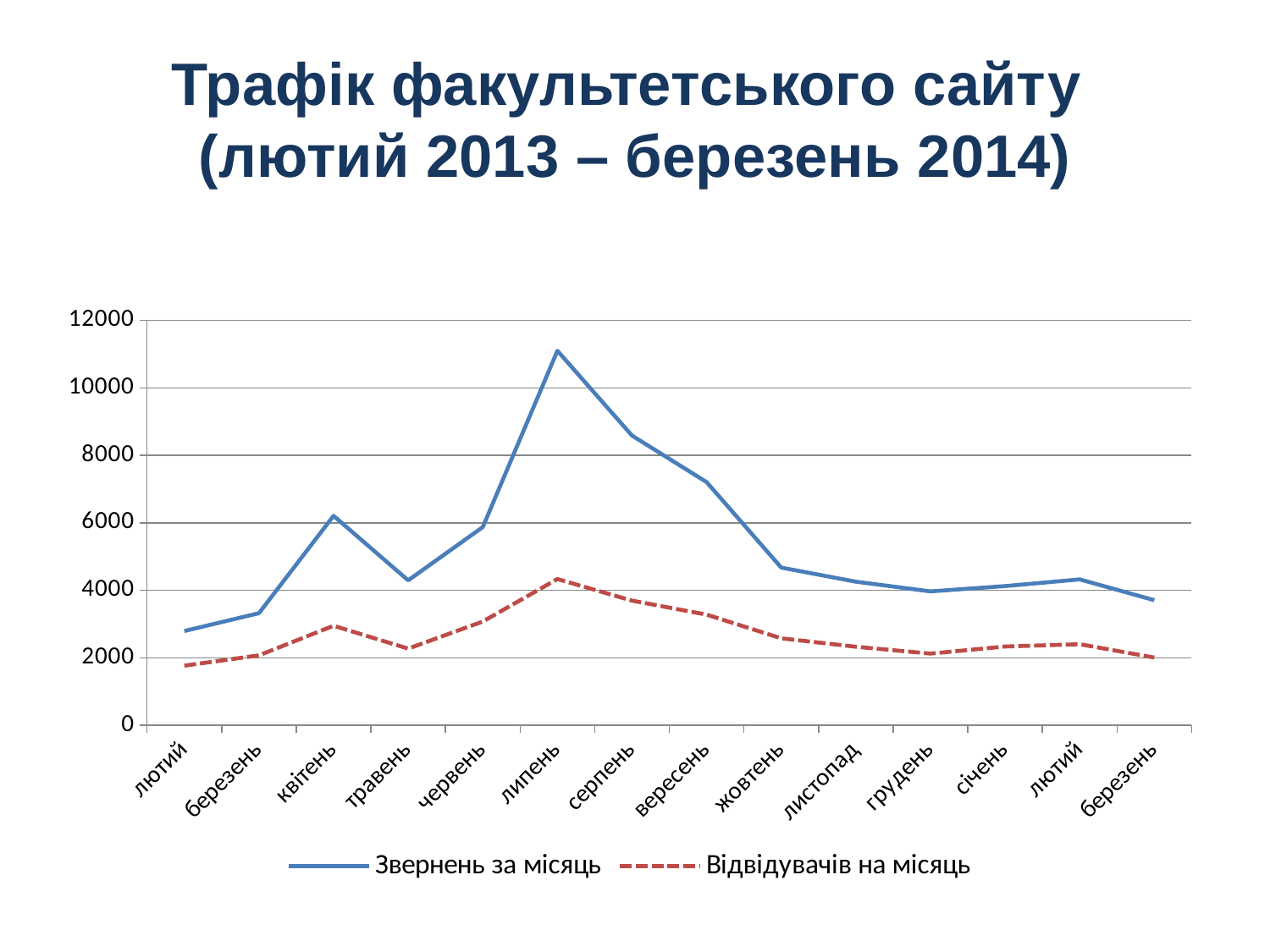
In which month is the series "Звернень за місяць" at its lowest value? лютий In which month does the series "Звернень за місяць" reach its highest value? липень What kind of chart is shown on the slide? line chart Which series has the larger value in липень, "Звернень за місяць" or "Відвідувачів на місяць"? Звернень за місяць Is the value of "Звернень за місяць" for липень greater or less than 10000? greater How many series does the legend list? 2 Which series is drawn with a dashed line? Відвідувачів на місяць In which month does the series "Відвідувачів на місяць" reach its highest value? липень Is the value of "Звернень за місяць" for жовтень greater or less than 6000? less How many months are plotted along the x axis? 14 Does the series "Звернень за місяць" rise or fall from липень to жовтень? fall Is the value of "Відвідувачів на місяць" for квітень greater or less than 4000? less